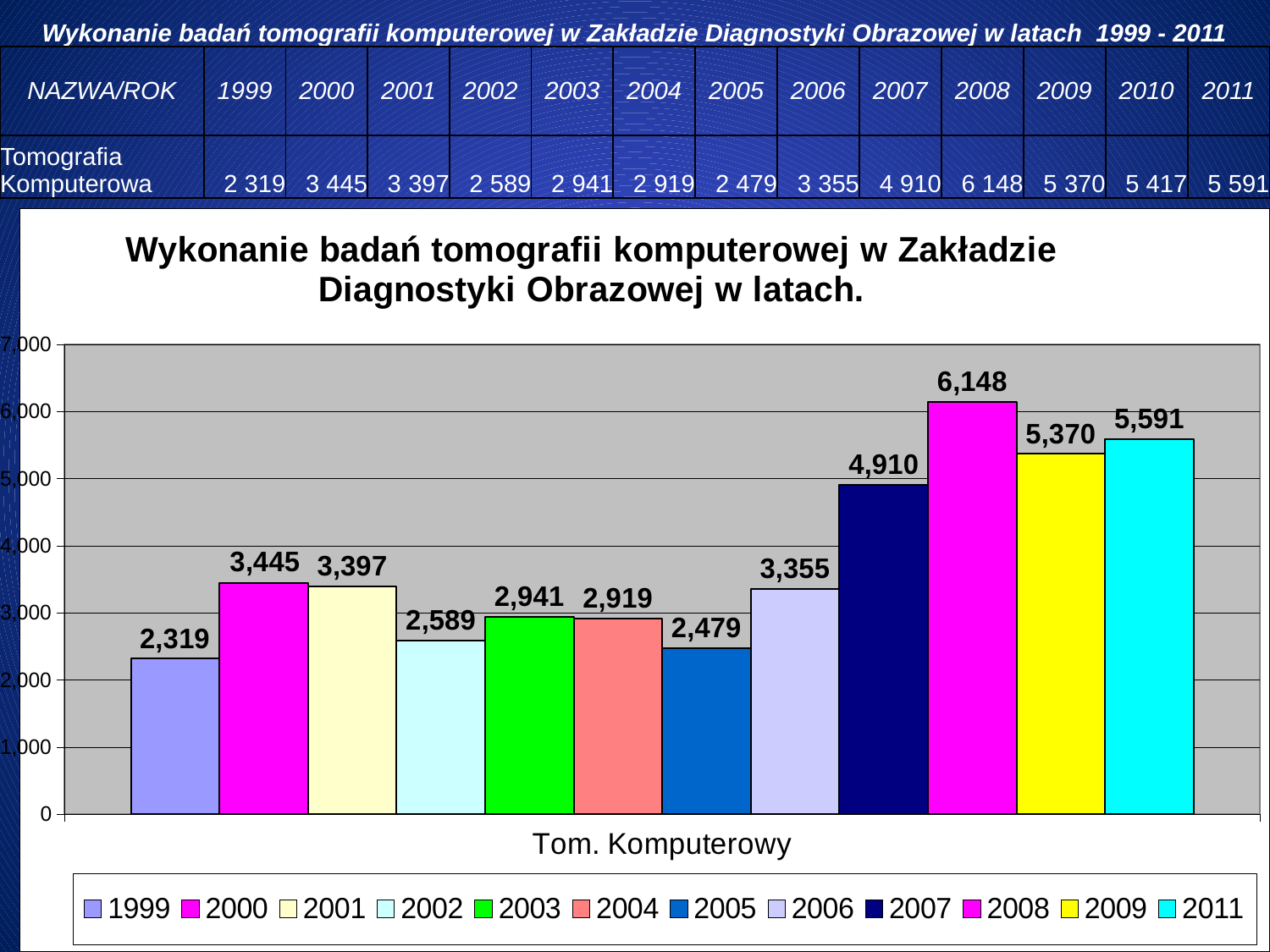
Which year has the lowest bar in the chart? 1999 What is the difference between the values for 2008 and 2007 in the chart? 1,238 What is the label shown on the x axis below the bars? Tom. Komputerowy What is the value of the bar for 2007 in the chart? 4,910 Which year has the highest bar in the chart? 2008 What is the value of the bar for 2008 in the chart? 6,148 Is the value for 2006 in the chart greater or less than 3,000? greater What is the value of the bar for 1999 in the chart? 2,319 How many entries does the chart legend list? 12 Which is larger in the chart, the value for 2009 or the value for 2011? 2011 What type of chart is shown on the slide? bar chart How many bars are plotted in the chart? 12